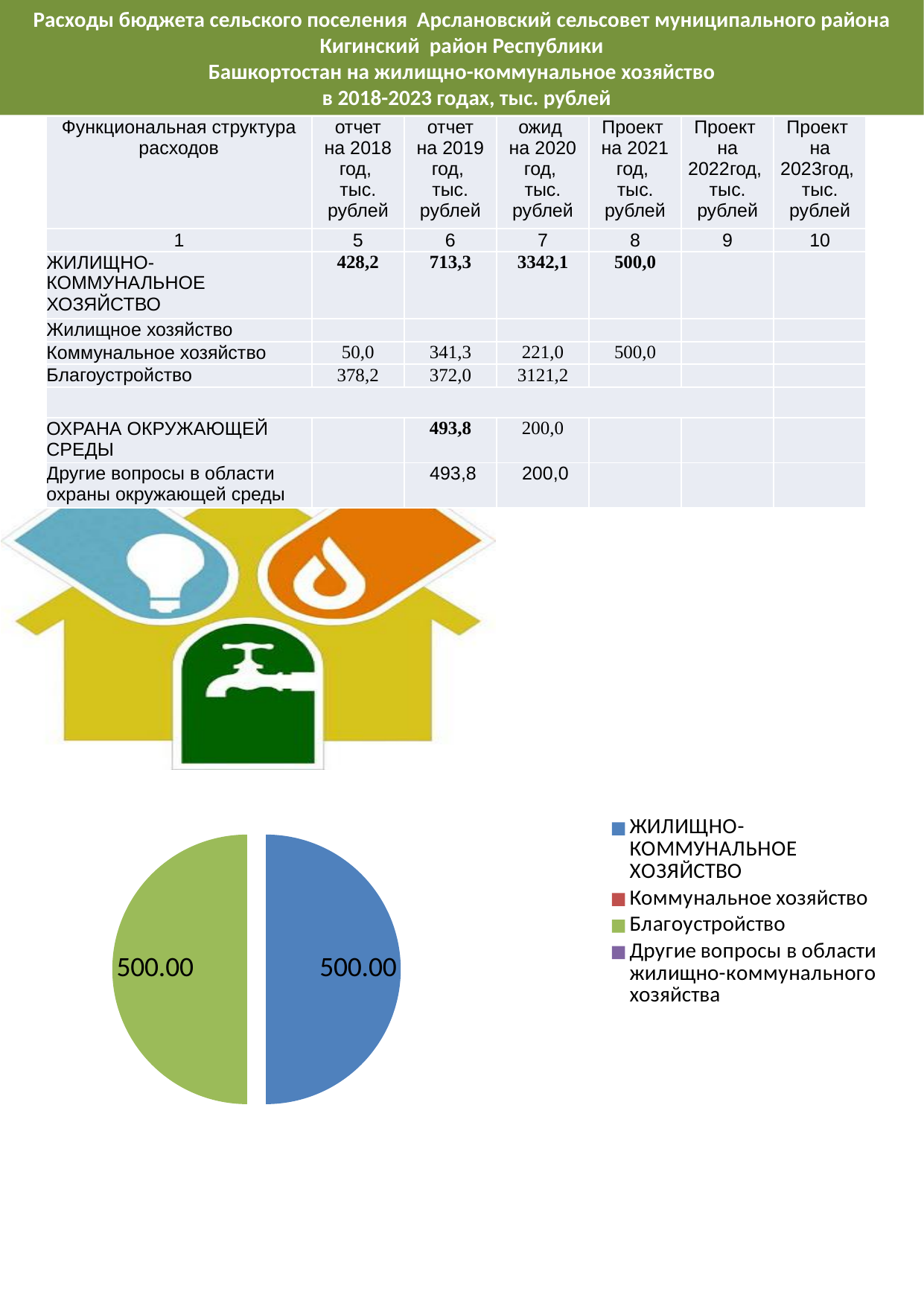
How many entries does the legend of the pie chart list? 4 In the pie chart, what value is shown for the blue slice labelled ЖИЛИЩНО-КОММУНАЛЬНОЕ ХОЗЯЙСТВО? 500.00 What kind of chart is shown at the bottom of the slide? pie chart In the pie chart, what is the total of the two labelled slices? 1000.00 Which legend entry in the pie chart is shown in blue? ЖИЛИЩНО-КОММУНАЛЬНОЕ ХОЗЯЙСТВО How many slices with data labels are visible in the pie chart? 2 In the pie chart, what is the difference between the value for ЖИЛИЩНО-КОММУНАЛЬНОЕ ХОЗЯЙСТВО and the value for Благоустройство? 0.00 In the pie chart, what share of the visible pie does the ЖИЛИЩНО-КОММУНАЛЬНОЕ ХОЗЯЙСТВО slice represent? 50% In the pie chart, what share of the visible pie does the Благоустройство slice represent? 50% In the pie chart, what value is shown for the green slice labelled Благоустройство? 500.00 What colour is the Благоустройство slice in the pie chart? green